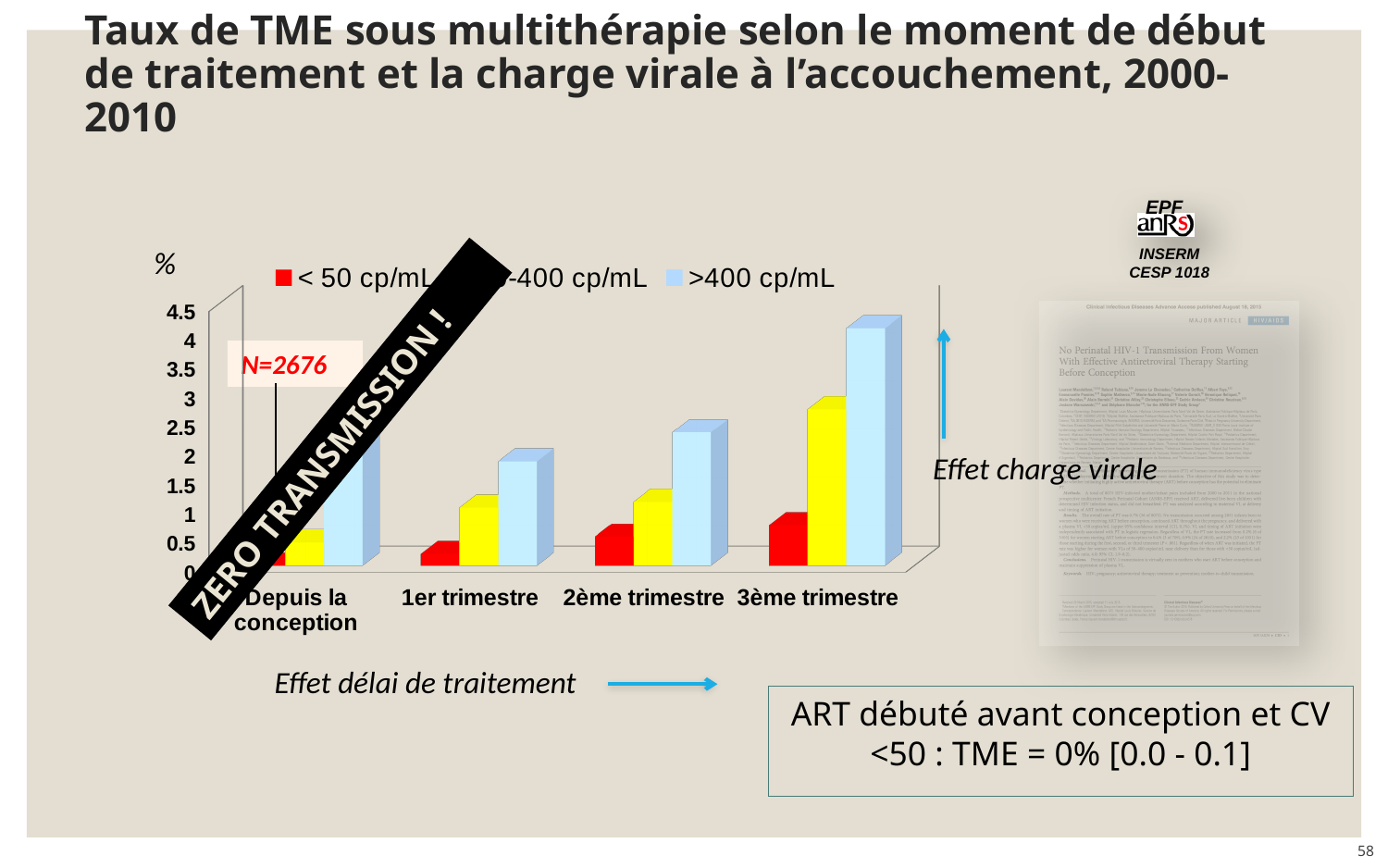
Do the values for the >400 cp/mL series rise or fall from 'Depuis la conception' to '3ème trimestre'? rise Which category has the lowest value for the < 50 cp/mL series? Depuis la conception What sample size (N) is indicated on the chart? N=2676 What type of chart is shown on the slide? bar chart What is the transmission rate for the < 50 cp/mL series in the 'Depuis la conception' category? 0% Is the value for >400 cp/mL in the 'Depuis la conception' category greater or less than 2.5? less Is the value for >400 cp/mL in the 3ème trimestre category greater or less than 3? greater Is the value for < 50 cp/mL in the 3ème trimestre category greater or less than 1.5? less How many series does the chart legend list? 3 How many treatment-start categories are shown on the x axis of the chart? 4 Which is larger: the >400 cp/mL value for 2ème trimestre or for 3ème trimestre? 3ème trimestre Which category has the highest value for the >400 cp/mL series? 3ème trimestre